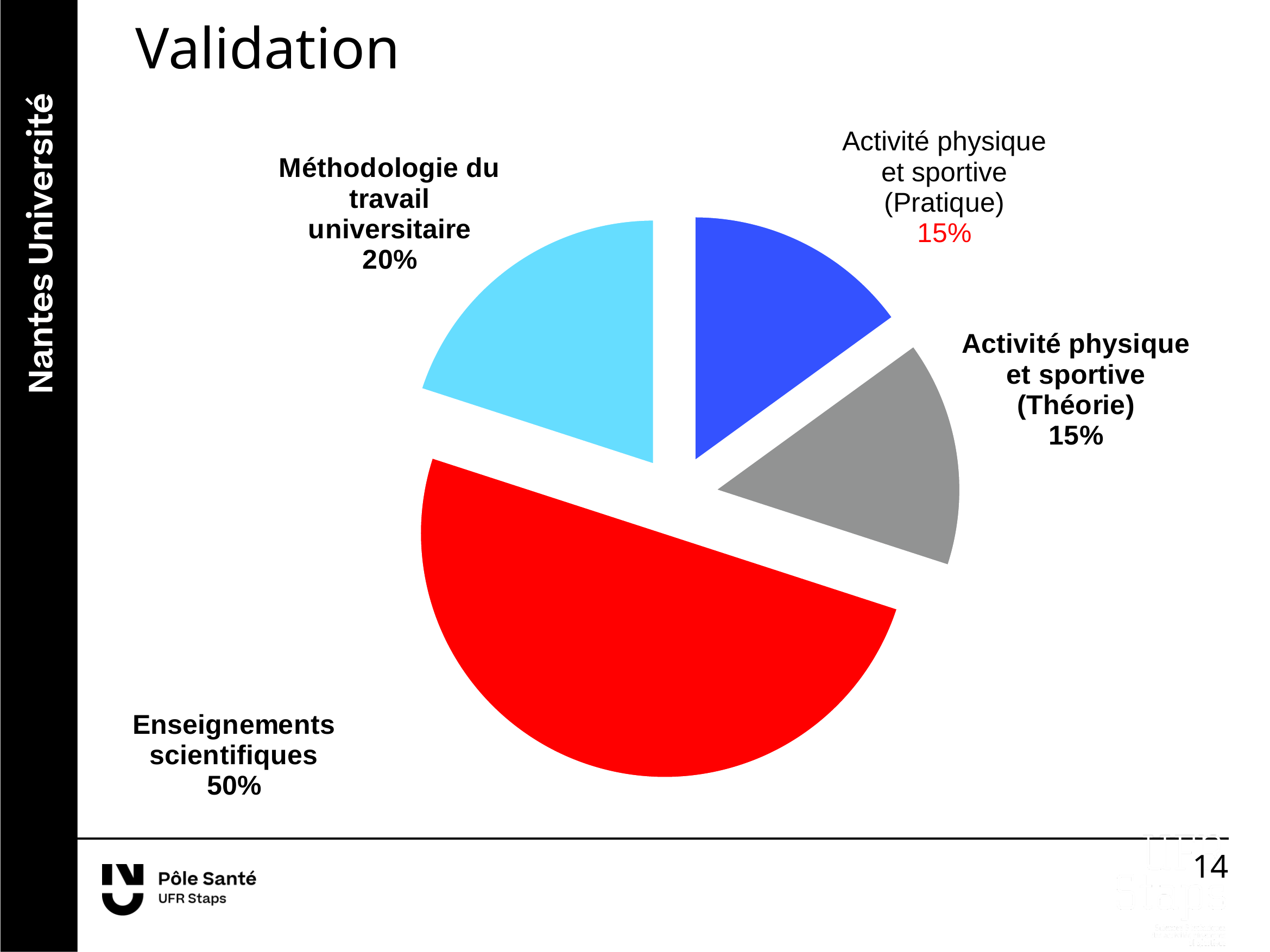
What colour is the Enseignements scientifiques slice? Red Which is larger: Méthodologie du travail universitaire or Activité physique et sportive (Théorie)? Méthodologie du travail universitaire What share of the pie is Activité physique et sportive (Pratique)? 15% What is the difference in percentage points between Enseignements scientifiques and Méthodologie du travail universitaire? 30 What is the title of the slide containing the pie chart? Validation What kind of chart is shown on the slide? Pie chart What share of the pie is Activité physique et sportive (Théorie)? 15% Which category has the largest share of the pie? Enseignements scientifiques How many slices does the pie chart have? 4 What share of the pie is Méthodologie du travail universitaire? 20% What is the combined share of Activité physique et sportive (Pratique) and Activité physique et sportive (Théorie)? 30%